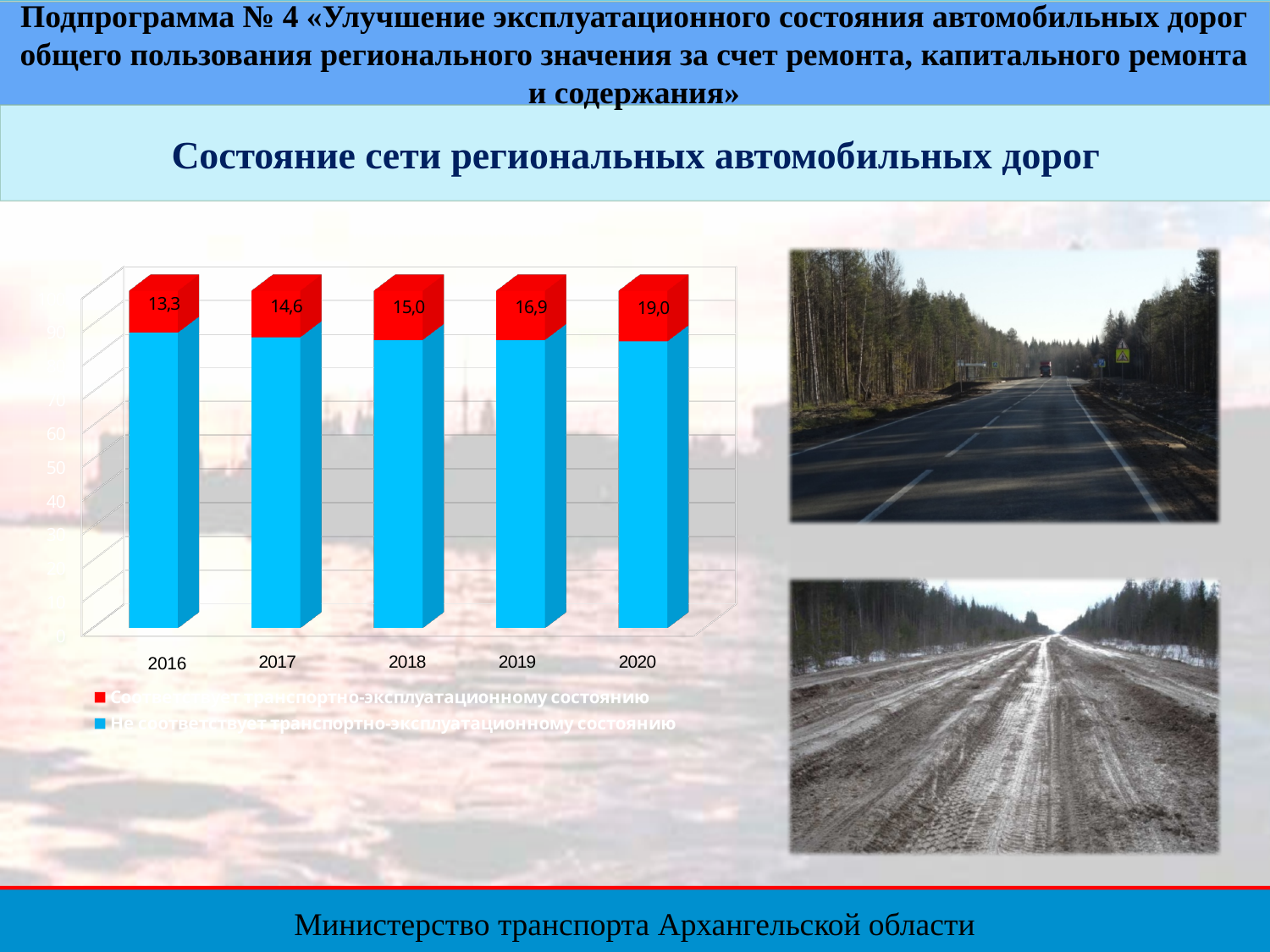
Is the blue segment (Не соответствует) for 2016 greater or less than 60? greater What is the value of the red segment for 2019? 16,9 How many series does the chart legend list? 2 What kind of chart is shown on the slide? Stacked bar chart In which year is the red segment (Соответствует) the largest? 2020 How many years are shown on the x axis of the chart? 5 What is the value of the red segment for 2018? 15,0 By how much does the red segment value for 2020 exceed that for 2016? 5,7 Which year has a larger red segment value, 2017 or 2019? 2019 What is the value of the red segment (Соответствует транспортно-эксплуатационному состоянию) for 2016? 13,3 In which year is the red segment (Соответствует) the smallest? 2016 What is the value of the red segment for 2020? 19,0